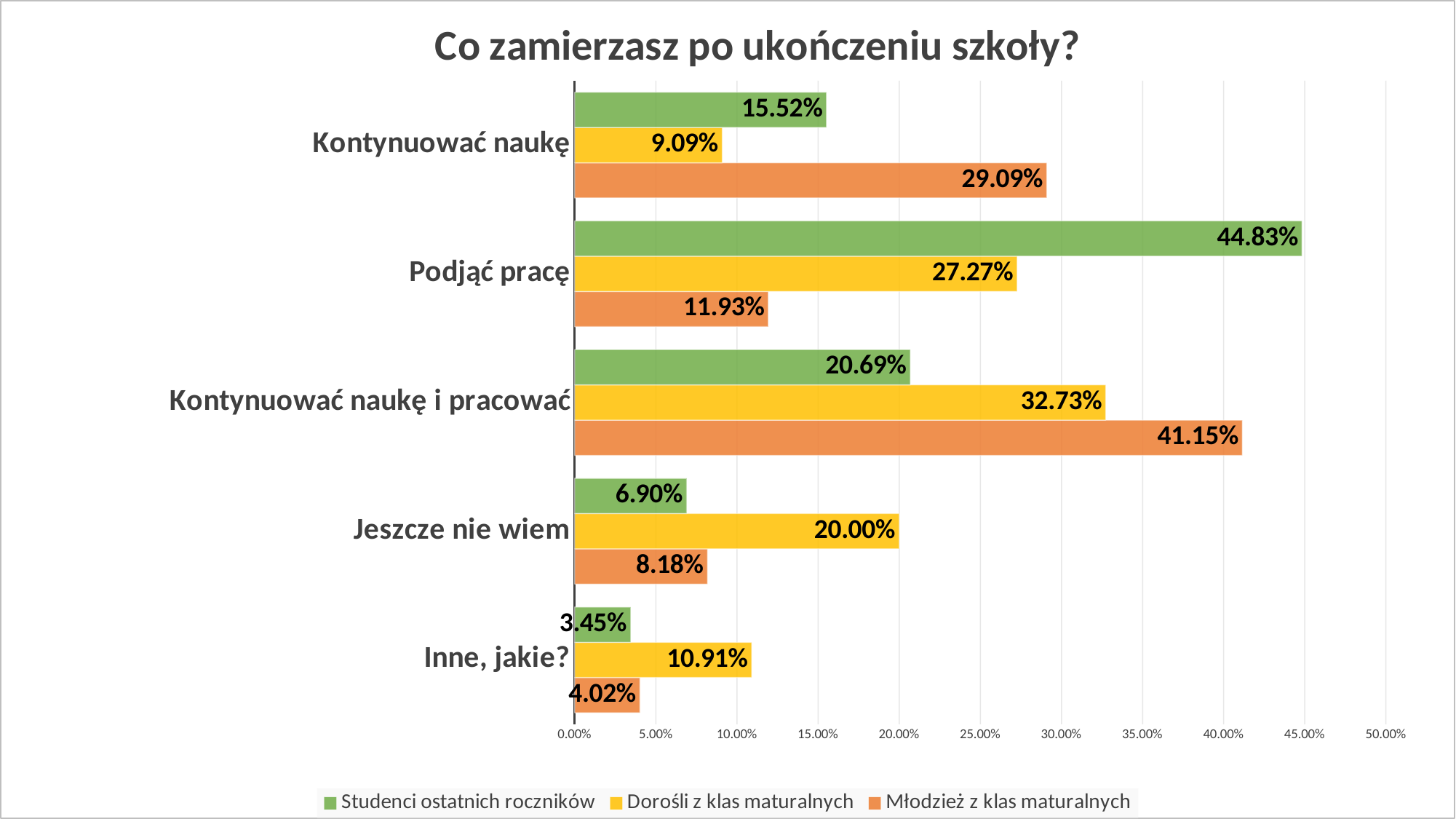
Which category has the highest value for 'Dorośli z klas maturalnych'? Kontynuować naukę i pracować How many categories are shown on the chart? 5 What is the value for 'Studenci ostatnich roczników' in the 'Podjąć pracę' category? 44.83% Which category has the lowest value for 'Młodzież z klas maturalnych'? Inne, jakie? What is the difference between 'Studenci ostatnich roczników' and 'Młodzież z klas maturalnych' in the 'Podjąć pracę' category? 32.90% What kind of chart is shown on the slide? Bar chart How many series does the legend list? 3 What is the value for 'Młodzież z klas maturalnych' in the 'Kontynuować naukę i pracować' category? 41.15% Which colour represents 'Dorośli z klas maturalnych' in the chart? Yellow In the 'Kontynuować naukę' category, which series has the larger value: 'Studenci ostatnich roczników' or 'Młodzież z klas maturalnych'? Młodzież z klas maturalnych What is the title of the chart? Co zamierzasz po ukończeniu szkoły? What is the value for 'Dorośli z klas maturalnych' in the 'Jeszcze nie wiem' category? 20.00%